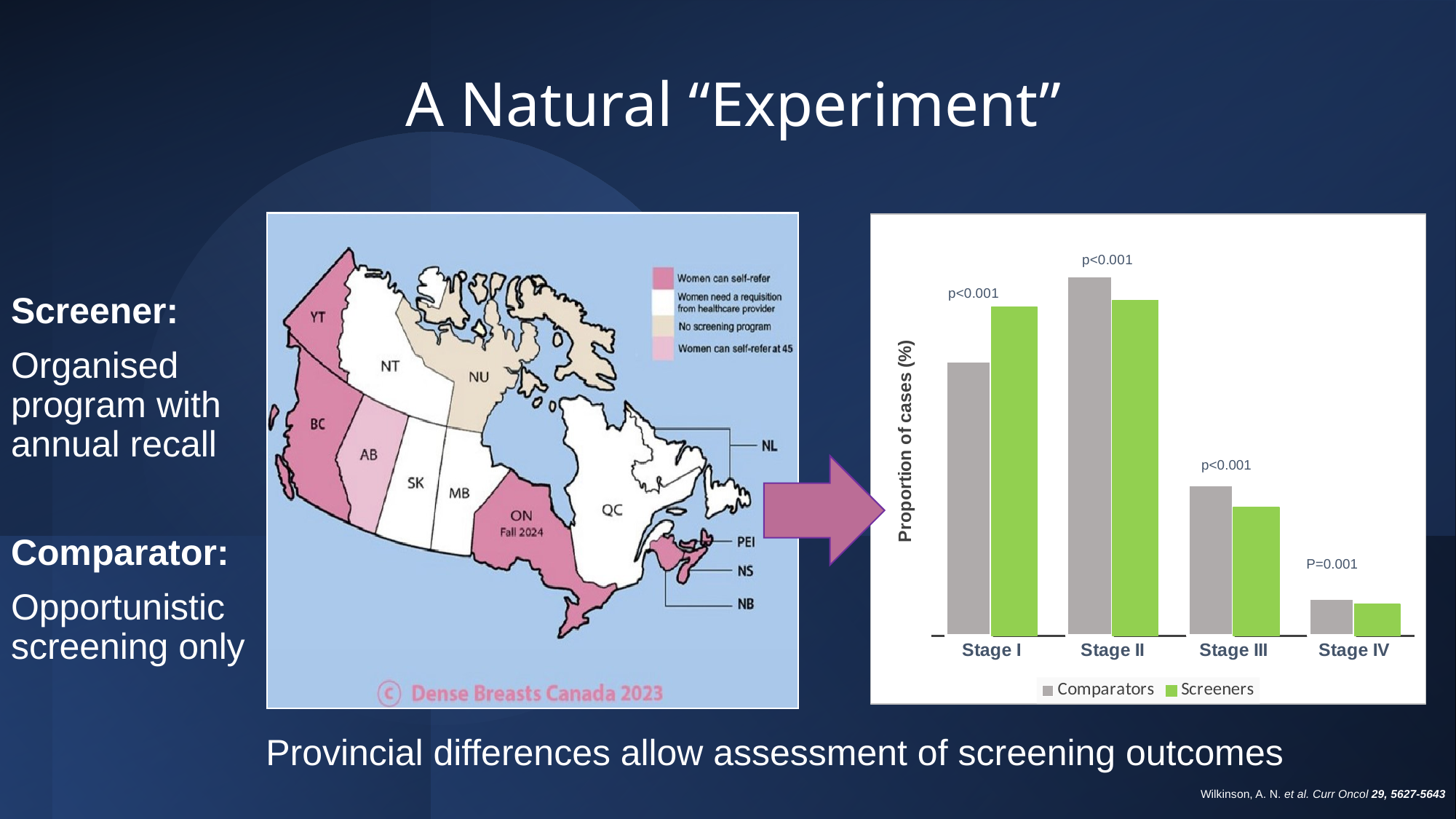
Which stage has the lowest value for Comparators in the bar chart? Stage IV How many stage categories are shown on the x axis of the bar chart? 4 What is the y-axis title of the bar chart? Proportion of cases (%) Do the Comparators values rise or fall from Stage II to Stage IV? fall At Stage II, which series has the larger value, Comparators or Screeners? Comparators What kind of chart is shown on the right of the slide? bar chart At Stage III, which series has the larger value, Comparators or Screeners? Comparators Which stage has the highest value for Comparators in the bar chart? Stage II At Stage I, which series has the larger value, Comparators or Screeners? Screeners What p-value annotation is printed above the Stage IV bars? P=0.001 Which stage has the lowest value for Screeners in the bar chart? Stage IV How many series does the legend of the bar chart list? 2